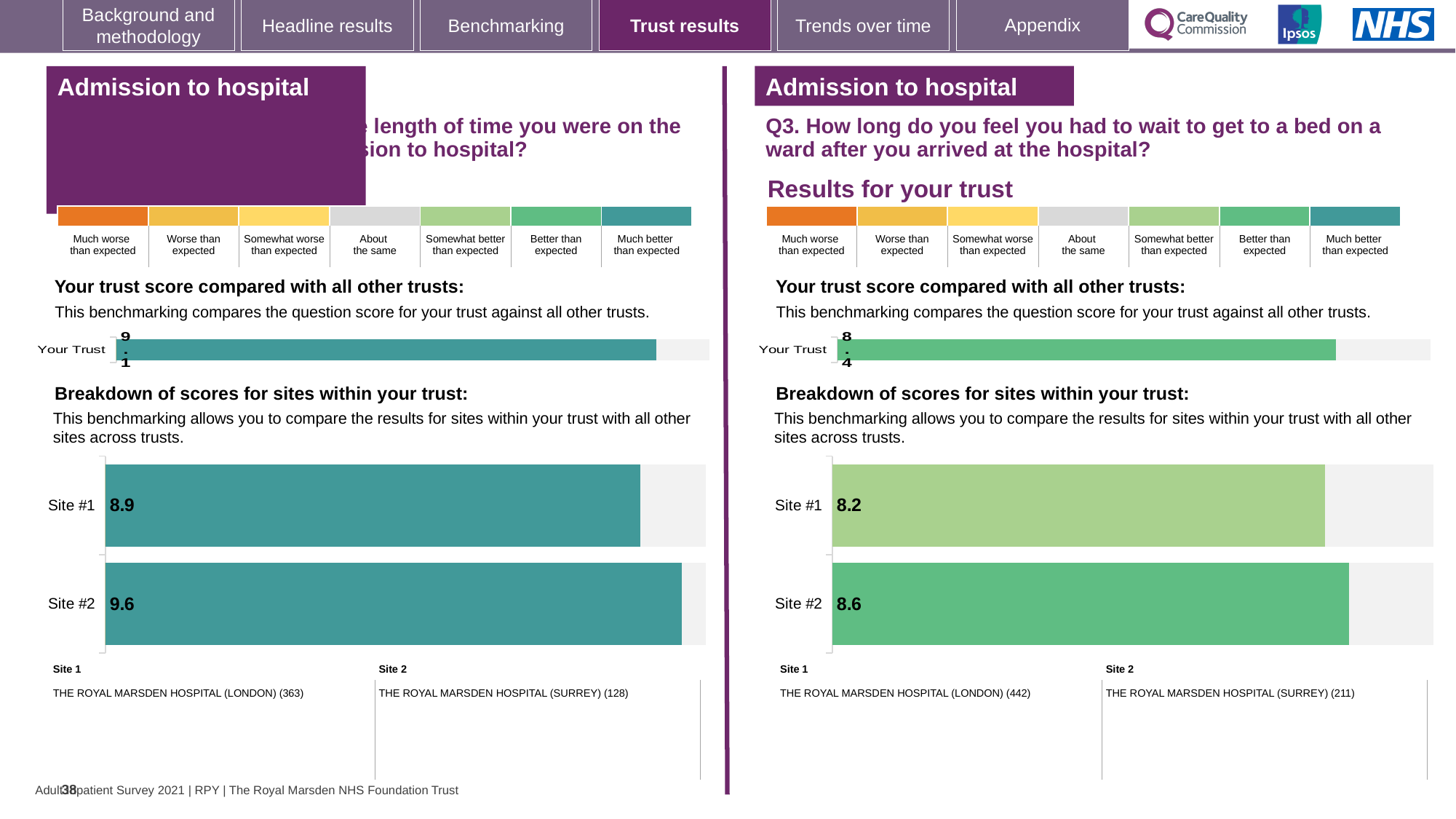
On the right-hand chart (Q3), which site has the higher score? Site #2 On the left-hand chart, what is the difference between the Site #2 and Site #1 scores? 0.7 On the left-hand chart, what is the 'Your Trust' score compared with all other trusts? 9.1 What kind of chart is used for the breakdown of scores for sites on the right-hand side (Q3)? Bar chart On the right-hand chart (Q3), what is the difference between the Site #2 and Site #1 scores? 0.4 On the right-hand chart (Q3), what is the 'Your Trust' score compared with all other trusts? 8.4 On the left-hand chart (breakdown of scores for sites), what is the score for Site #2? 9.6 On the left-hand chart, which site has the lower score? Site #1 On the right-hand chart (Q3, wait to get to a bed on a ward), what is the score for Site #1? 8.2 How many sites are shown in the site breakdown chart on the right-hand side (Q3)? 2 On the right-hand chart (Q3, wait to get to a bed on a ward), what is the score for Site #2? 8.6 On the left-hand chart (breakdown of scores for sites), what is the score for Site #1? 8.9